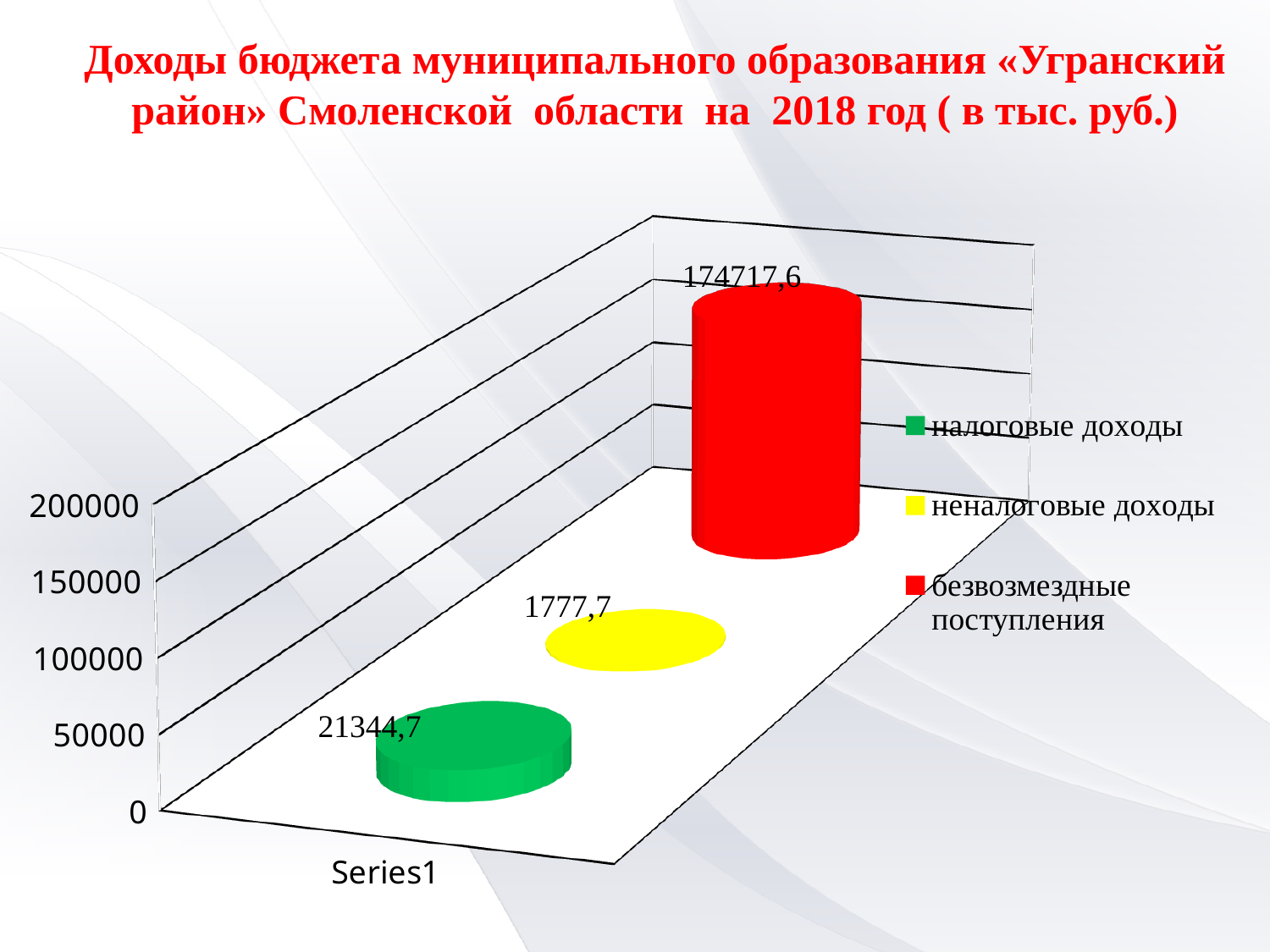
What is the difference between налоговые доходы and неналоговые доходы? 19567,0 What is the difference between безвозмездные поступления and налоговые доходы? 153372,9 What kind of chart is shown on the slide? bar chart What colour represents безвозмездные поступления in the chart? red How many series does the legend list? 3 What is the value for неналоговые доходы? 1777,7 Which is larger, налоговые доходы or неналоговые доходы? налоговые доходы Which series has the highest value? безвозмездные поступления What is the value for безвозмездные поступления? 174717,6 What is the value for налоговые доходы? 21344,7 Is the value for безвозмездные поступления greater or less than 150000? greater Which series has the lowest value? неналоговые доходы